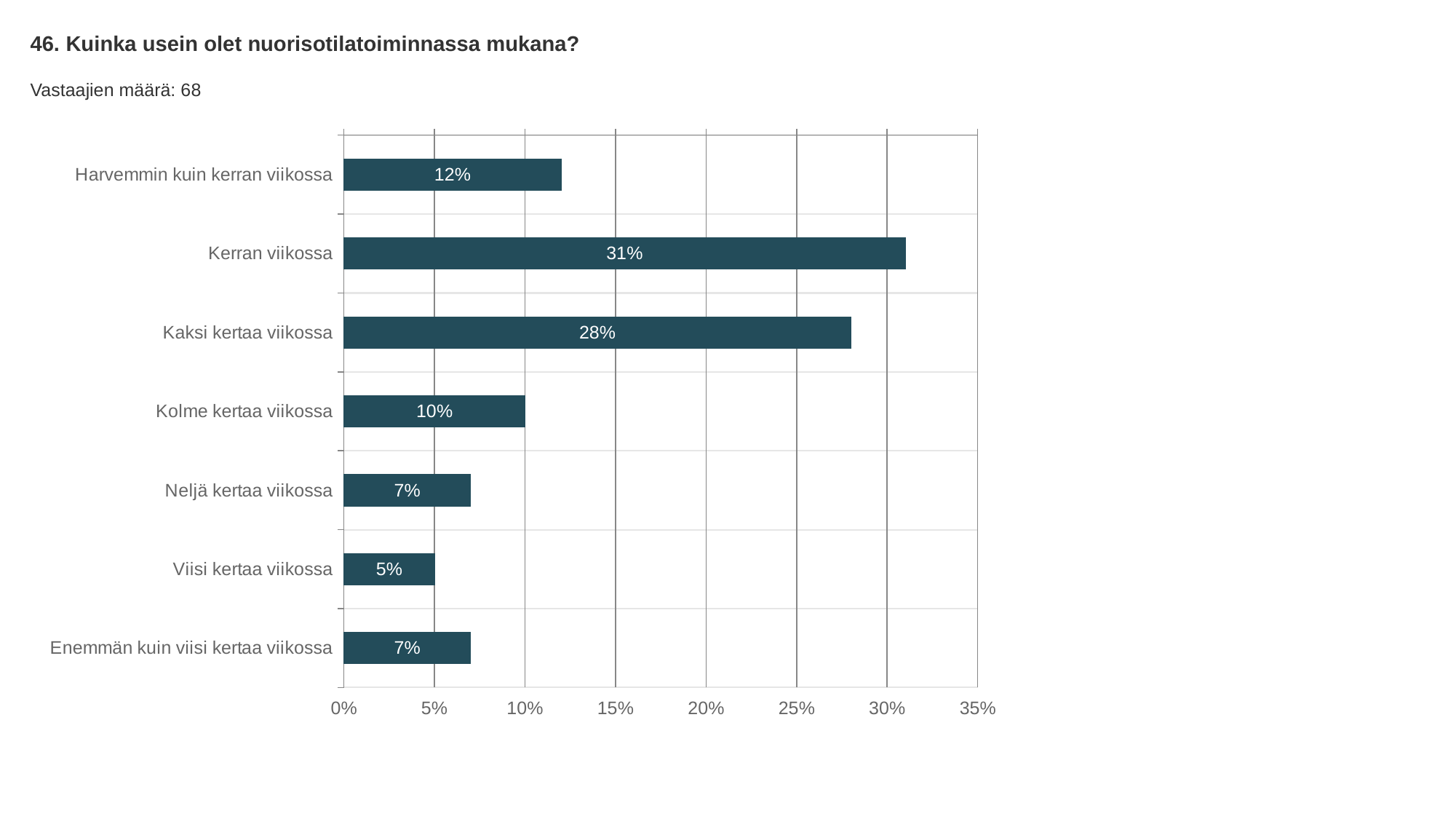
Which is larger, the value for "Kaksi kertaa viikossa" or the value for "Kolme kertaa viikossa"? Kaksi kertaa viikossa What is the difference between the values for "Kerran viikossa" and "Kaksi kertaa viikossa"? 3% What is the value for "Harvemmin kuin kerran viikossa"? 12% Is the value for "Kaksi kertaa viikossa" greater or less than 25%? greater What kind of chart is shown on the slide? bar chart What is the value for "Viisi kertaa viikossa"? 5% Which category has the highest value? Kerran viikossa How many respondents (Vastaajien määrä) are reported on the slide? 68 How many categories are shown in the chart? 7 What is the value for "Kerran viikossa"? 31% What is the difference between the values for "Harvemmin kuin kerran viikossa" and "Kolme kertaa viikossa"? 2% Which category has the lowest value? Viisi kertaa viikossa